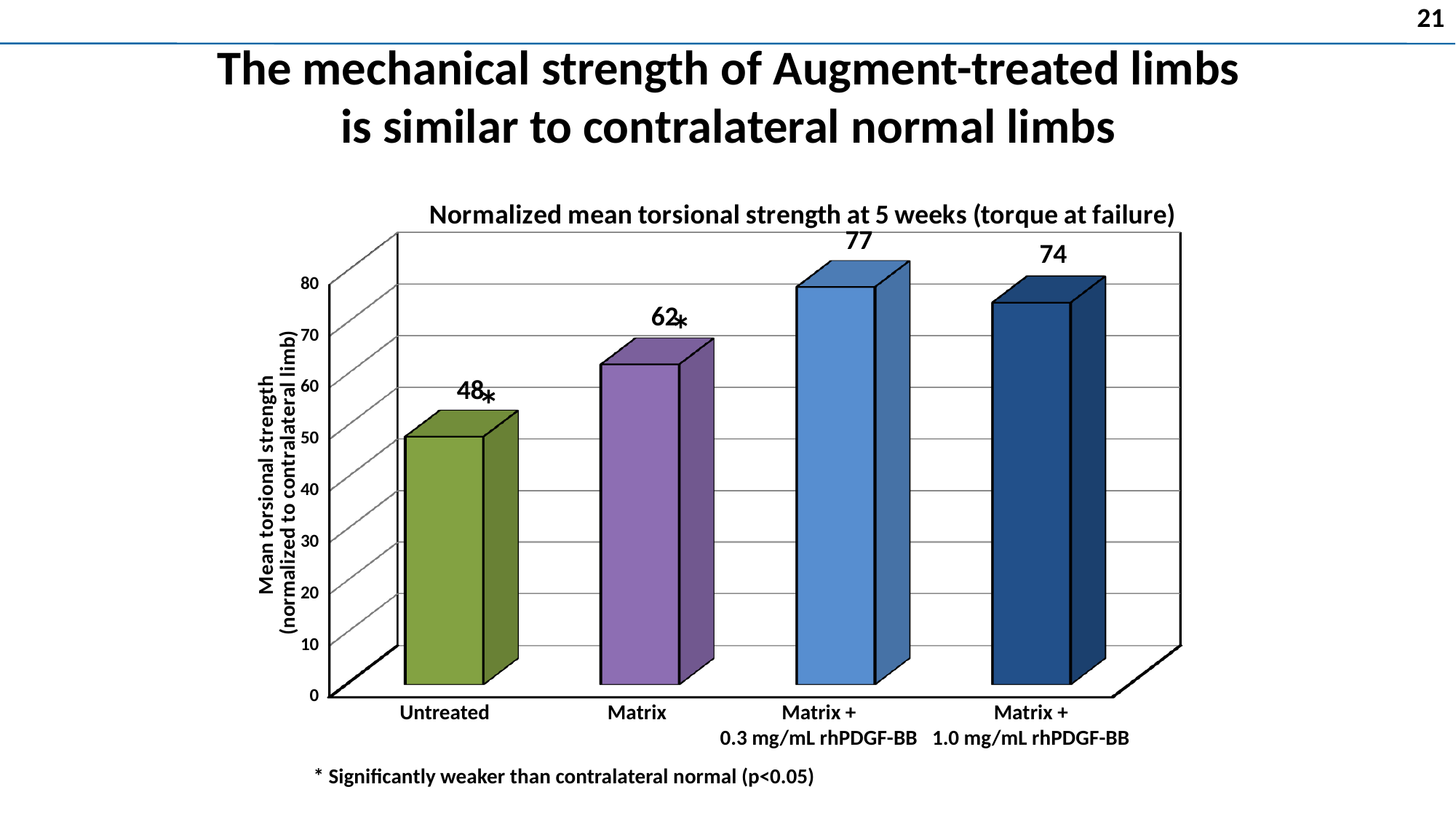
Which is larger, the value for Matrix or the value for Matrix + 1.0 mg/mL rhPDGF-BB? Matrix + 1.0 mg/mL rhPDGF-BB What is the normalized mean torsional strength for the Matrix group? 62 What is the difference in torsional strength between Matrix + 0.3 mg/mL rhPDGF-BB and Untreated? 29 What type of chart is shown on the slide? Bar chart What is the value for Matrix + 1.0 mg/mL rhPDGF-BB? 74 Which group has the lowest normalized mean torsional strength? Untreated What is the normalized mean torsional strength for the Untreated group? 48 How many groups are shown in the chart? 4 What is the value for Matrix + 0.3 mg/mL rhPDGF-BB? 77 What is the difference between the Matrix group and the Untreated group? 14 Which group has the highest normalized mean torsional strength? Matrix + 0.3 mg/mL rhPDGF-BB What is the title of the chart? Normalized mean torsional strength at 5 weeks (torque at failure)